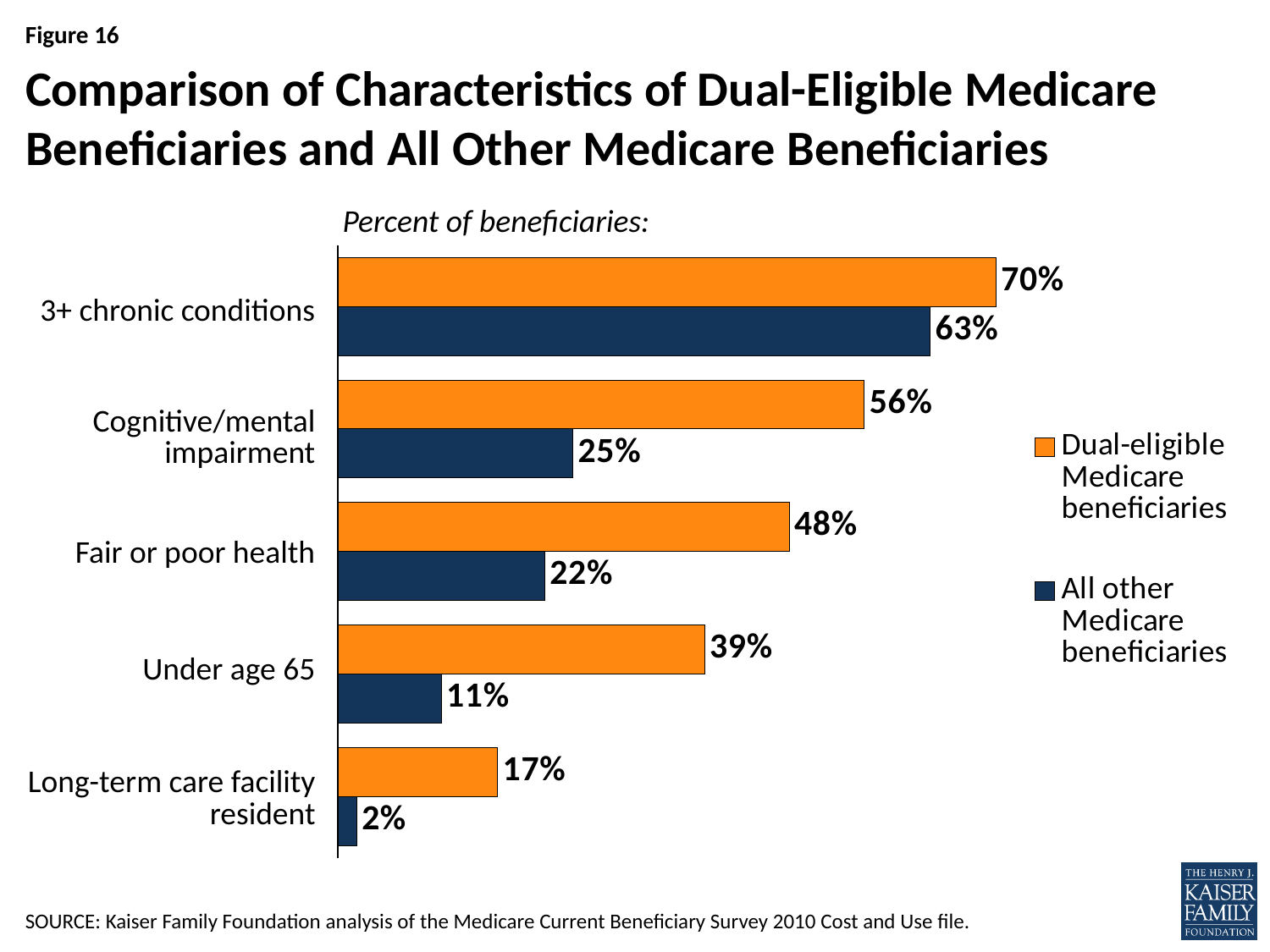
How many series does the legend list? 2 What is the difference between dual-eligible and all other Medicare beneficiaries for 'Long-term care facility resident'? 15 percentage points What percent of dual-eligible Medicare beneficiaries have 3+ chronic conditions? 70% What percent of all other Medicare beneficiaries have a cognitive/mental impairment? 25% Which colour represents dual-eligible Medicare beneficiaries in the chart? Orange How many categories are shown on the chart? 5 What kind of chart is shown on the slide? Bar chart Which category has the highest value for dual-eligible Medicare beneficiaries? 3+ chronic conditions What is the difference between dual-eligible and all other Medicare beneficiaries for 'Fair or poor health'? 26 percentage points Which is larger: the dual-eligible value for 'Cognitive/mental impairment' or the all other beneficiaries value for '3+ chronic conditions'? All other beneficiaries value for 3+ chronic conditions Which category has the lowest value for all other Medicare beneficiaries? Long-term care facility resident What is the value for 'Under age 65' among all other Medicare beneficiaries? 11%